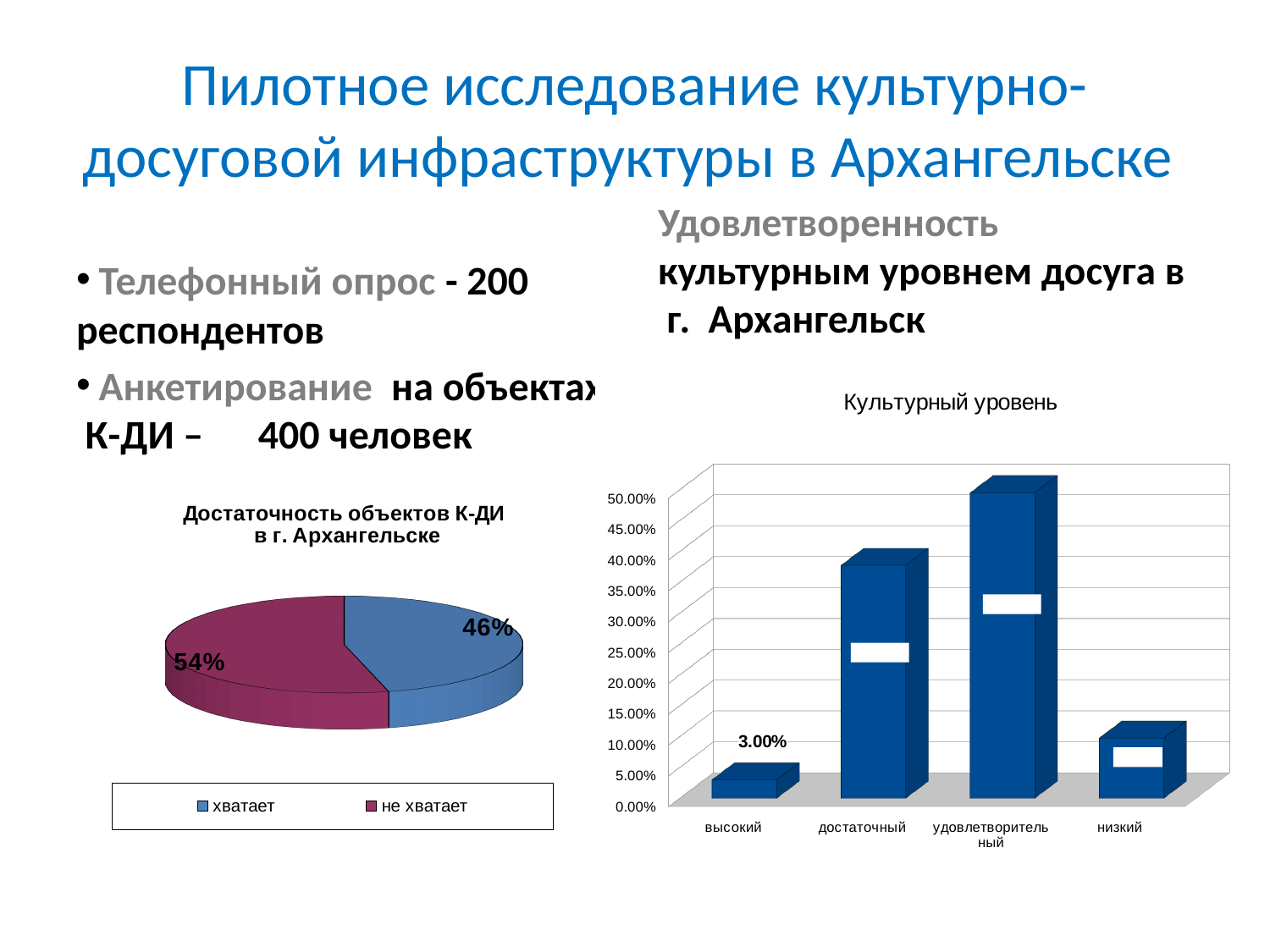
In the pie chart 'Достаточность объектов К-ДИ в г. Архангельске', what is the difference in percentage points between 'не хватает' and 'хватает'? 8% In the chart 'Культурный уровень', what is the value for 'высокий'? 3.00% What kind of chart is 'Достаточность объектов К-ДИ в г. Архангельске'? Pie chart In the chart 'Культурный уровень', is the value for 'достаточный' greater or less than 30.00%? greater How many categories are shown on the x axis of the chart 'Культурный уровень'? 4 In the pie chart 'Достаточность объектов К-ДИ в г. Архангельске', which slice is larger, 'хватает' or 'не хватает'? не хватает In the chart 'Культурный уровень', which category has the highest value? удовлетворительный In the chart 'Культурный уровень', is the value for 'низкий' greater or less than 15.00%? less In the chart 'Культурный уровень', which category has the lowest value? высокий In the pie chart 'Достаточность объектов К-ДИ в г. Архангельске', what share is labelled for 'хватает'? 46% In the pie chart 'Достаточность объектов К-ДИ в г. Архангельске', what share is labelled for 'не хватает'? 54% How many entries does the legend of the pie chart 'Достаточность объектов К-ДИ в г. Архангельске' list? 2